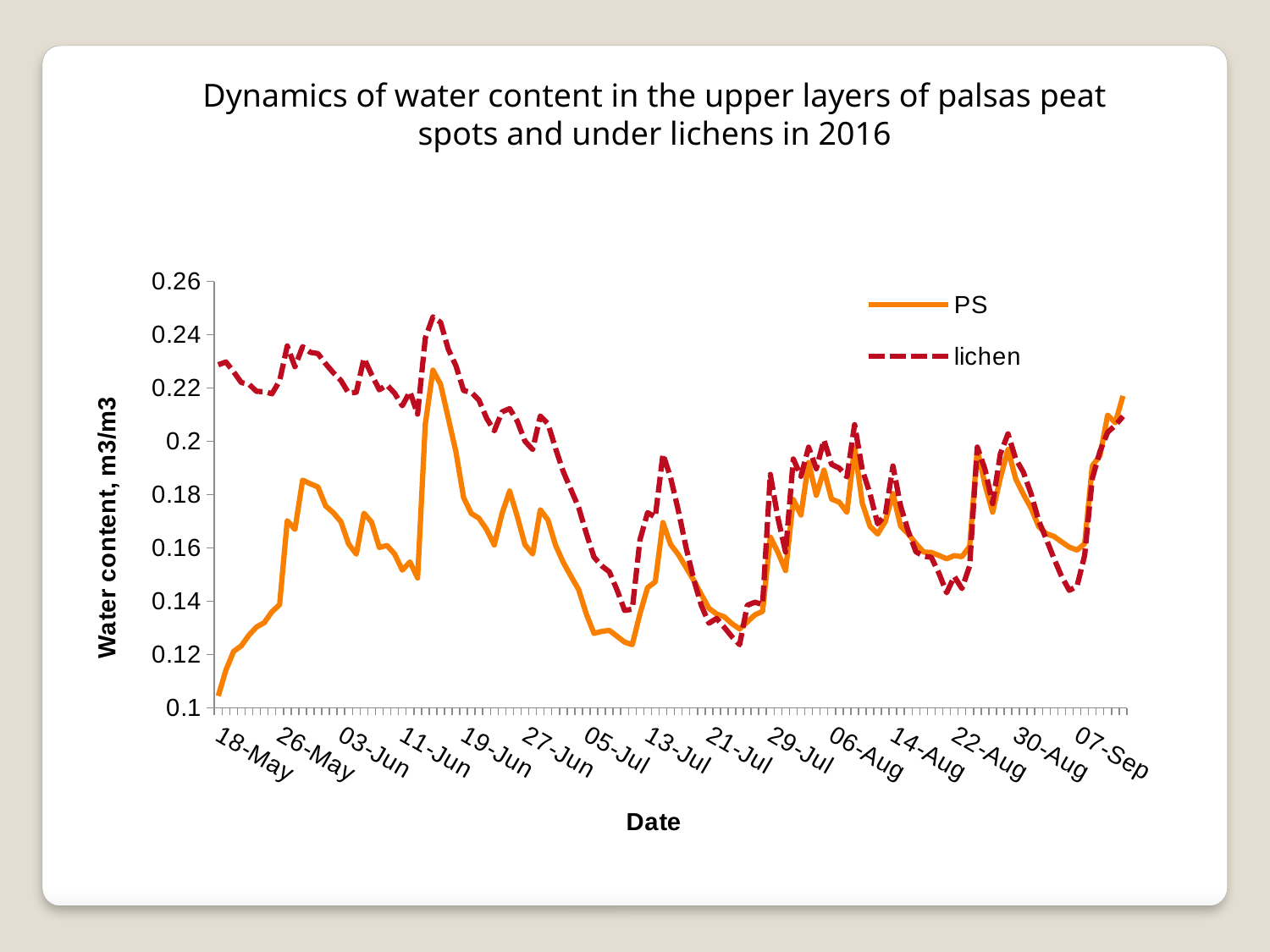
Does the PS series rise or fall between 18-May and 26-May? rise Is the value for PS on 18-May greater or less than 0.12? less On 26-May, which series has the higher water content, PS or lichen? lichen Which series reaches the highest water content value anywhere on the chart? lichen Is the value for PS on 07-Sep greater or less than 0.2? less Is the value for lichen on 18-May greater or less than 0.22? greater Which series has the lowest water content value anywhere on the chart? PS What is the label of the vertical axis? Water content, m3/m3 What are the two series named in the legend? PS and lichen How many series does the legend list? 2 What kind of chart is shown on the slide? line chart